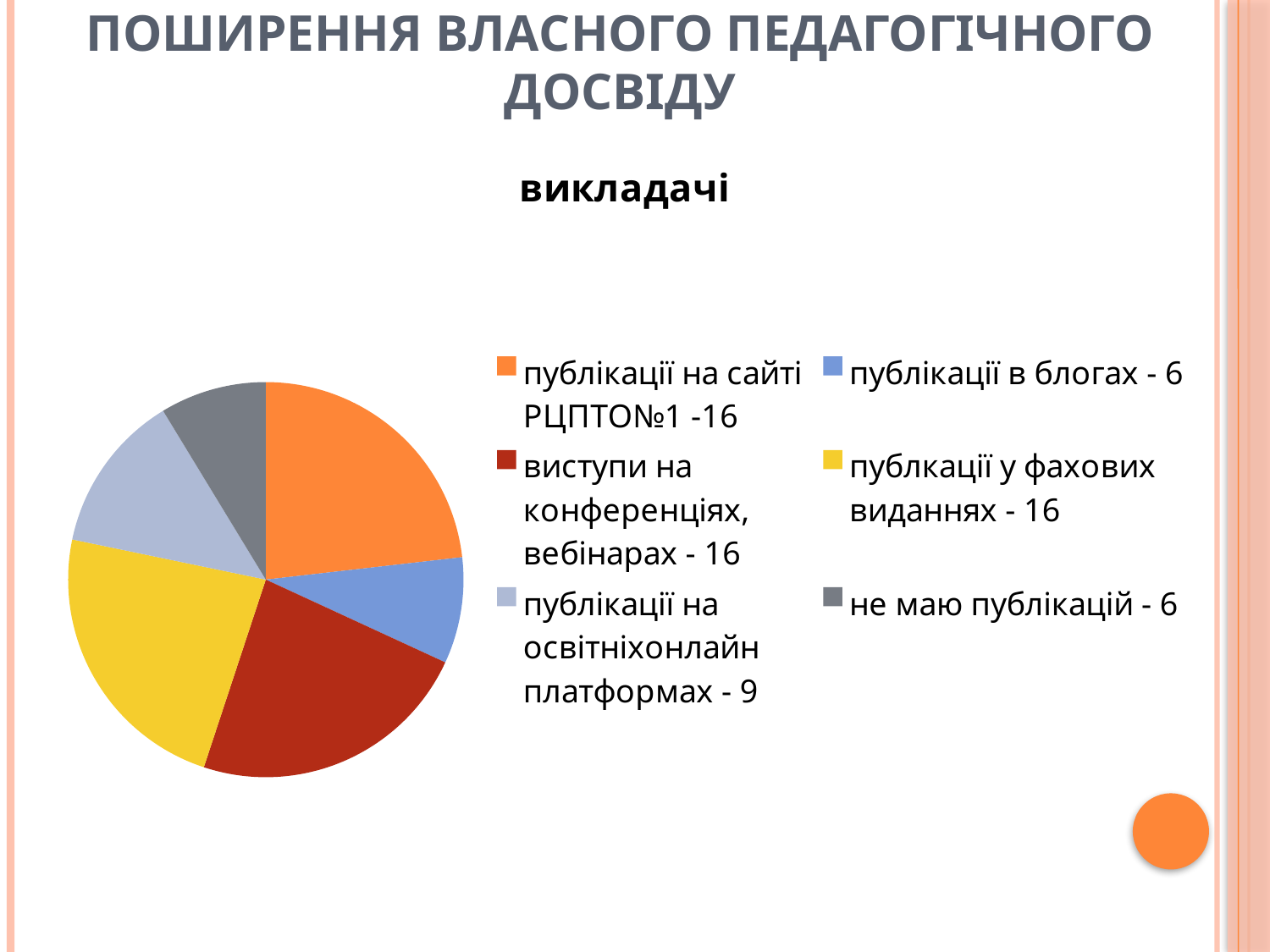
What is the value for "публікації на освітніх онлайн платформах"? 9 What kind of chart is shown on the slide? pie chart What is the title of the chart? викладачі What is the difference between "виступи на конференціях, вебінарах" and "публікації на освітніх онлайн платформах"? 7 What is the value for "публікації на сайті РЦПТО№1"? 16 What is the value for "виступи на конференціях, вебінарах"? 16 Which category is shown in orange on the pie chart? публікації на сайті РЦПТО№1 Which is larger: "публкації у фахових виданнях" or "публікації в блогах"? публкації у фахових виданнях What is the value for "публікації в блогах"? 6 What is the value for "не маю публікацій"? 6 How many categories does the pie chart have? 6 What is the difference between "публікації на освітніх онлайн платформах" and "не маю публікацій"? 3